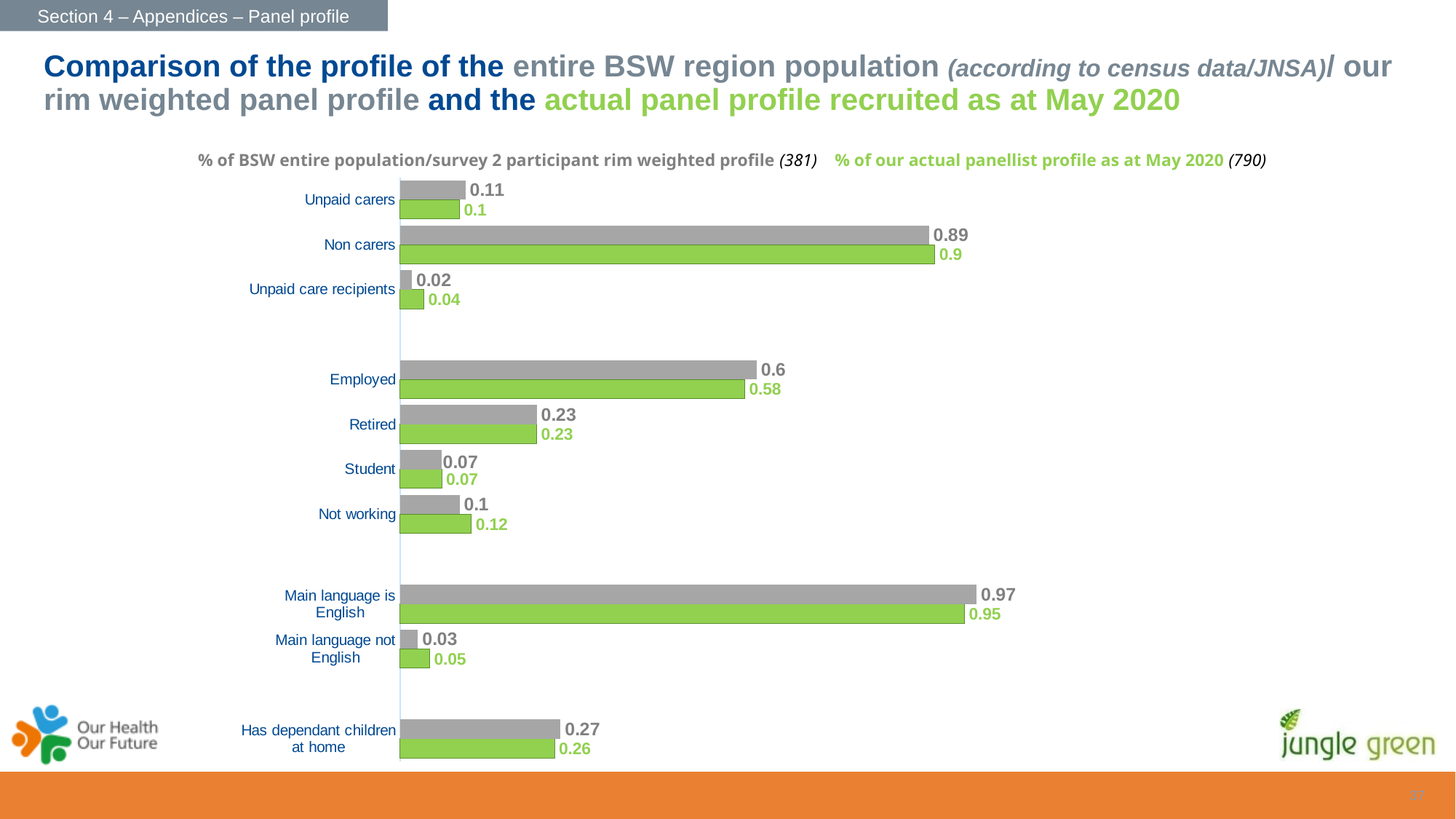
How many categories are shown on the chart? 10 Which category has the highest value in the '% of BSW entire population/survey 2 participant rim weighted profile' series? Main language is English For Not working, which series has the larger value: the rim weighted profile or the actual panellist profile? Actual panellist profile Which category has the lowest value in the '% of BSW entire population/survey 2 participant rim weighted profile' series? Unpaid care recipients What colour are the bars for the '% of our actual panellist profile as at May 2020' series? Green What is the value for Retired in the '% of our actual panellist profile as at May 2020' series? 0.23 What is the value for Employed in the '% of our actual panellist profile as at May 2020' series? 0.58 What is the value for Non carers in the '% of BSW entire population/survey 2 participant rim weighted profile' series? 0.89 How many series does the chart show? 2 What kind of chart is shown on the slide? Bar chart What is the value for Unpaid care recipients in the '% of our actual panellist profile as at May 2020' series? 0.04 What is the difference between the rim weighted profile value and the actual panellist profile value for Employed? 0.02